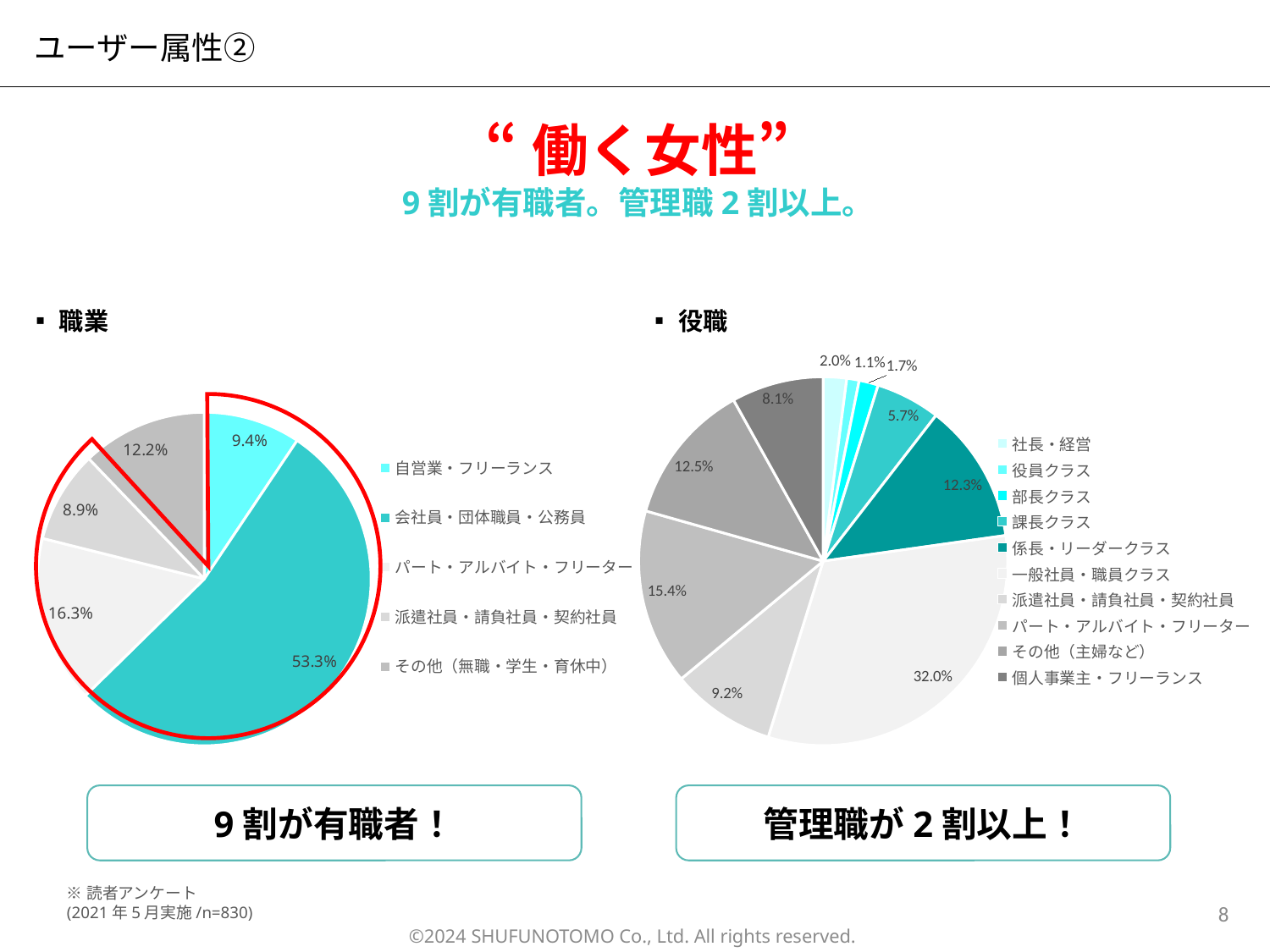
In the 職業 pie chart, what percentage is shown for パート・アルバイト・フリーター? 16.3% In the 役職 pie chart, which category has the smallest share? 役員クラス In the 職業 pie chart, which category has the smallest share? 派遣社員・請負社員・契約社員 In the 役職 pie chart, what percentage is shown for 一般社員・職員クラス? 32.0% In the 職業 pie chart, how many categories does the legend list? 5 In the 役職 pie chart, how many categories does the legend list? 10 In the 役職 pie chart, what is the difference between the shares of 課長クラス and 部長クラス? 4.0% In the 役職 pie chart, what percentage is shown for 係長・リーダークラス? 12.3% In the 職業 pie chart, what is the difference between the shares of 自営業・フリーランス and 派遣社員・請負社員・契約社員? 0.5% In the 役職 pie chart, which is larger: パート・アルバイト・フリーター or その他（主婦など）? パート・アルバイト・フリーター In the 職業 pie chart, what percentage is shown for 会社員・団体職員・公務員? 53.3% What type of chart is used for 役職? Pie chart